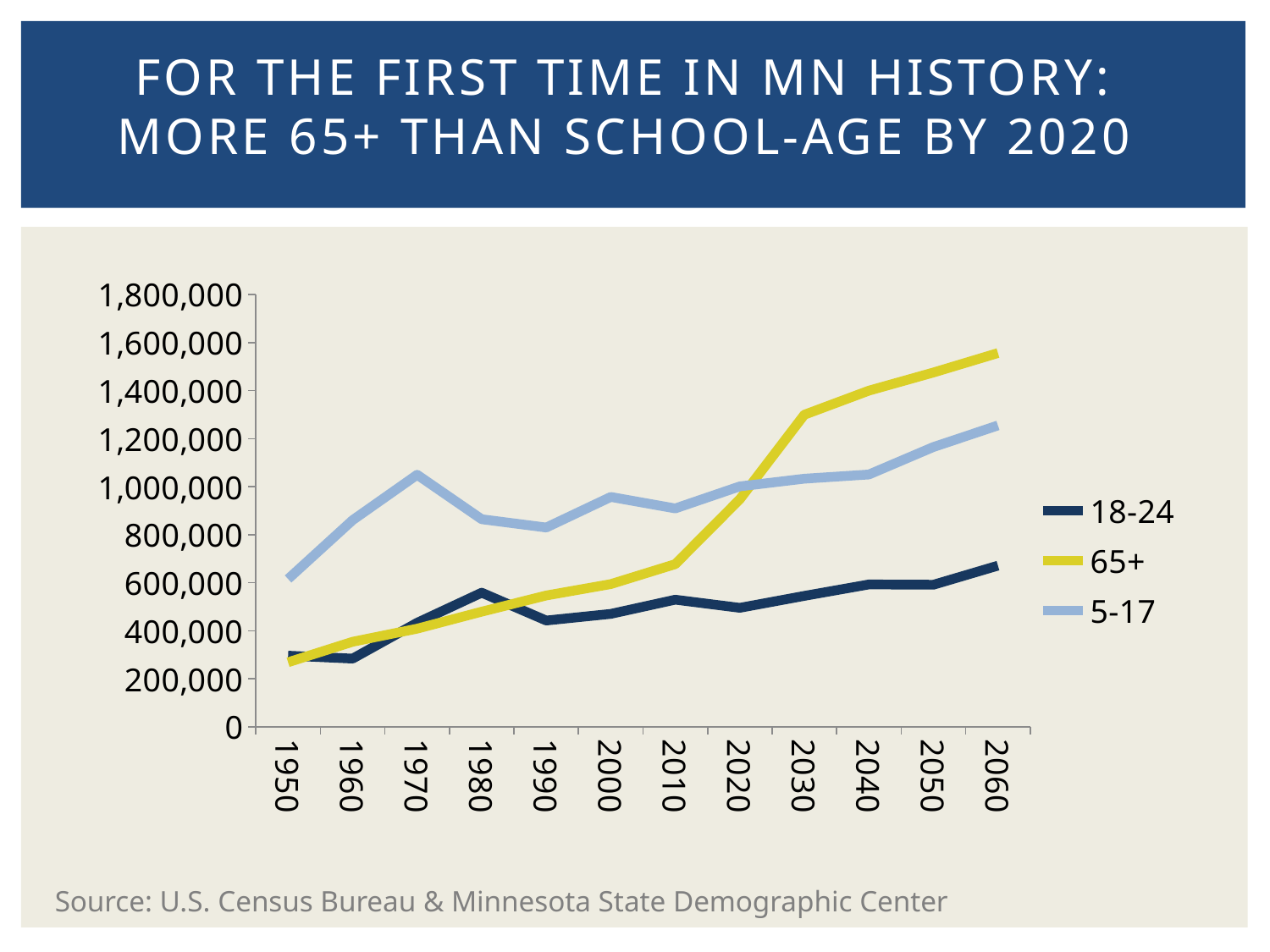
How many series does the legend list? 3 Is the value for the 65+ series in 1950 greater or less than 400,000? less Is the value for the 65+ series in 2060 greater or less than 1,400,000? greater How many years are marked along the x axis? 12 In 2060, which is larger: the 65+ series or the 5-17 series? 65+ What are the three entries in the chart legend? 18-24, 65+, 5-17 Which series has the highest value in 2060? 65+ Does the 65+ series rise or fall from 1950 to 2060? rise Which series has the lowest value in 2060? 18-24 In 1990, which is larger: the 5-17 series or the 65+ series? 5-17 Is the value for the 18-24 series in 2060 greater or less than 800,000? less What kind of chart is shown on the slide? line chart